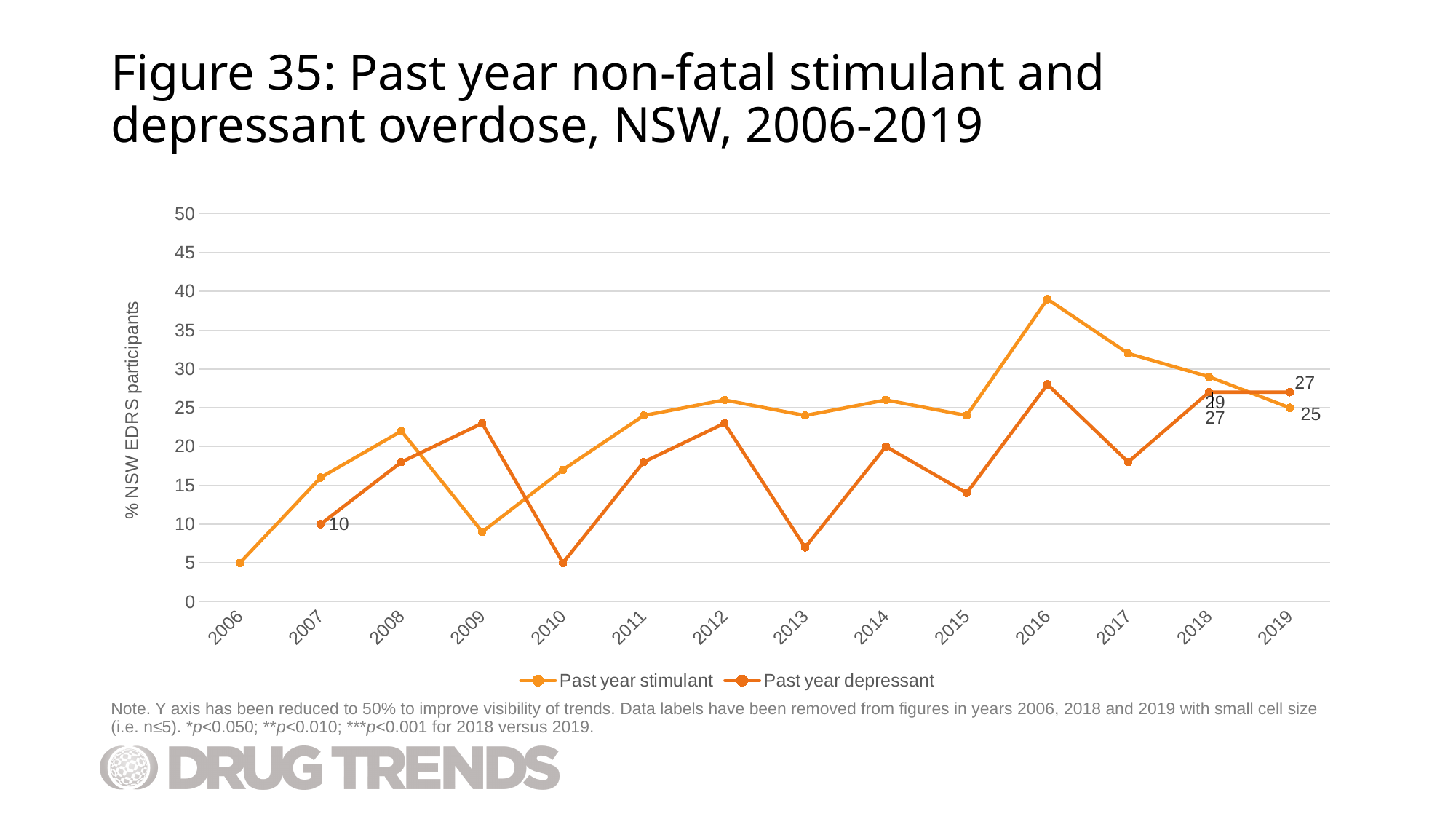
Is the value for Past year stimulant in 2016 greater or less than 35? greater How many series does the legend list? 2 In which year does the Past year stimulant series reach its highest value? 2016 In 2019, which series has the higher value, Past year stimulant or Past year depressant? Past year depressant Is the value for Past year depressant in 2010 greater or less than 10? less By how much did the Past year stimulant value fall from 2018 to 2019? 4 How many years are shown on the x axis? 14 What is the value for Past year depressant in 2019? 27 What is the value for Past year depressant in 2007? 10 What is the value for Past year stimulant in 2019? 25 What kind of chart is shown on the slide? Line chart What is the value for Past year stimulant in 2018? 29